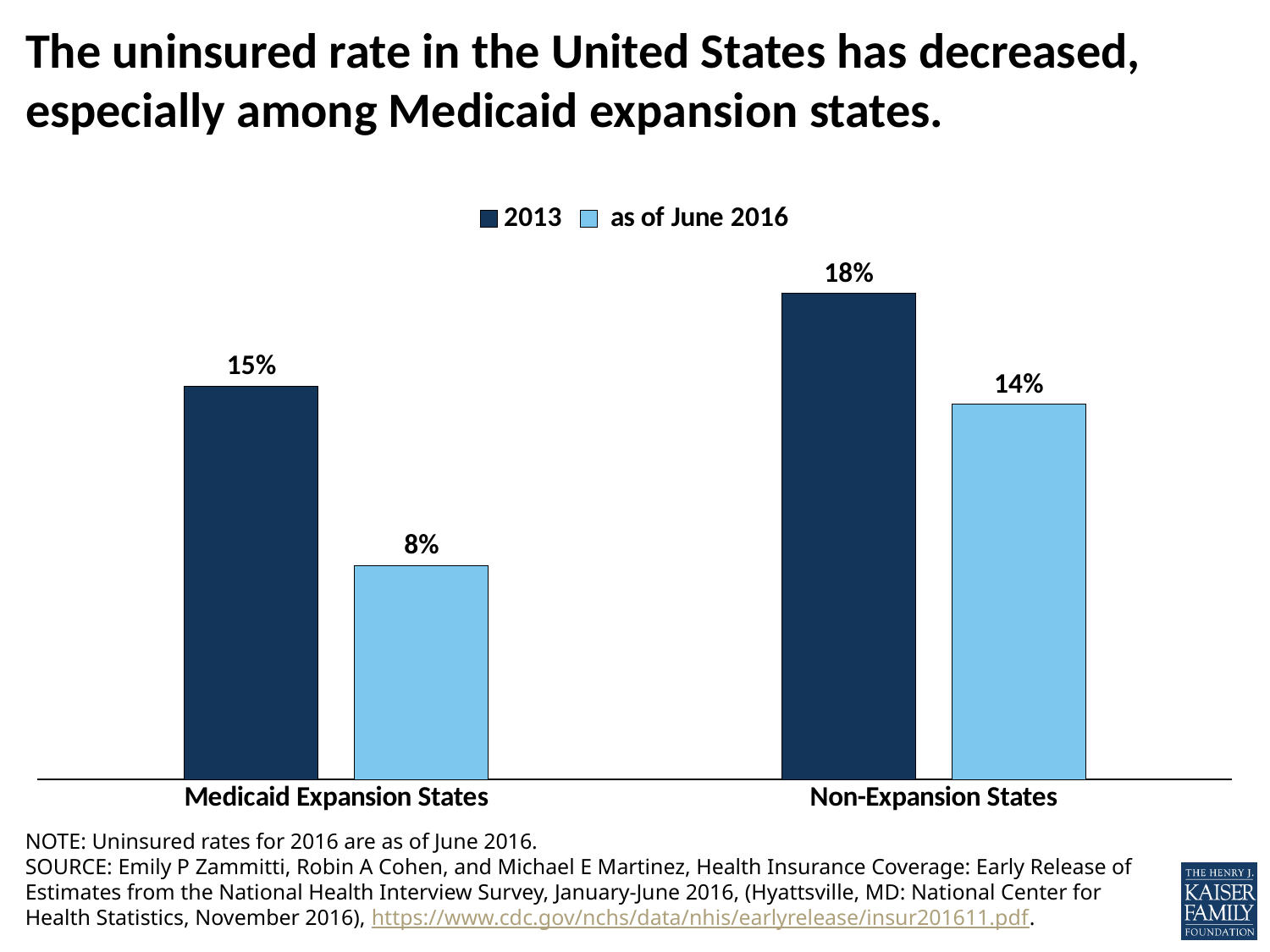
Which bar shows the highest uninsured rate on the chart? Non-Expansion States, 2013 How many series does the legend list? 2 Which bar shows the lowest uninsured rate on the chart? Medicaid Expansion States, as of June 2016 What was the uninsured rate in Medicaid Expansion States in 2013? 15% By how many percentage points did the uninsured rate in Medicaid Expansion States fall from 2013 to June 2016? 7 percentage points What kind of chart is shown on the slide? Bar chart What was the uninsured rate in Non-Expansion States as of June 2016? 14% What was the uninsured rate in Medicaid Expansion States as of June 2016? 8% How many categories of states are shown on the x axis? 2 As of June 2016, which group had the higher uninsured rate: Medicaid Expansion States or Non-Expansion States? Non-Expansion States What was the uninsured rate in Non-Expansion States in 2013? 18% By how many percentage points did the uninsured rate in Non-Expansion States fall from 2013 to June 2016? 4 percentage points